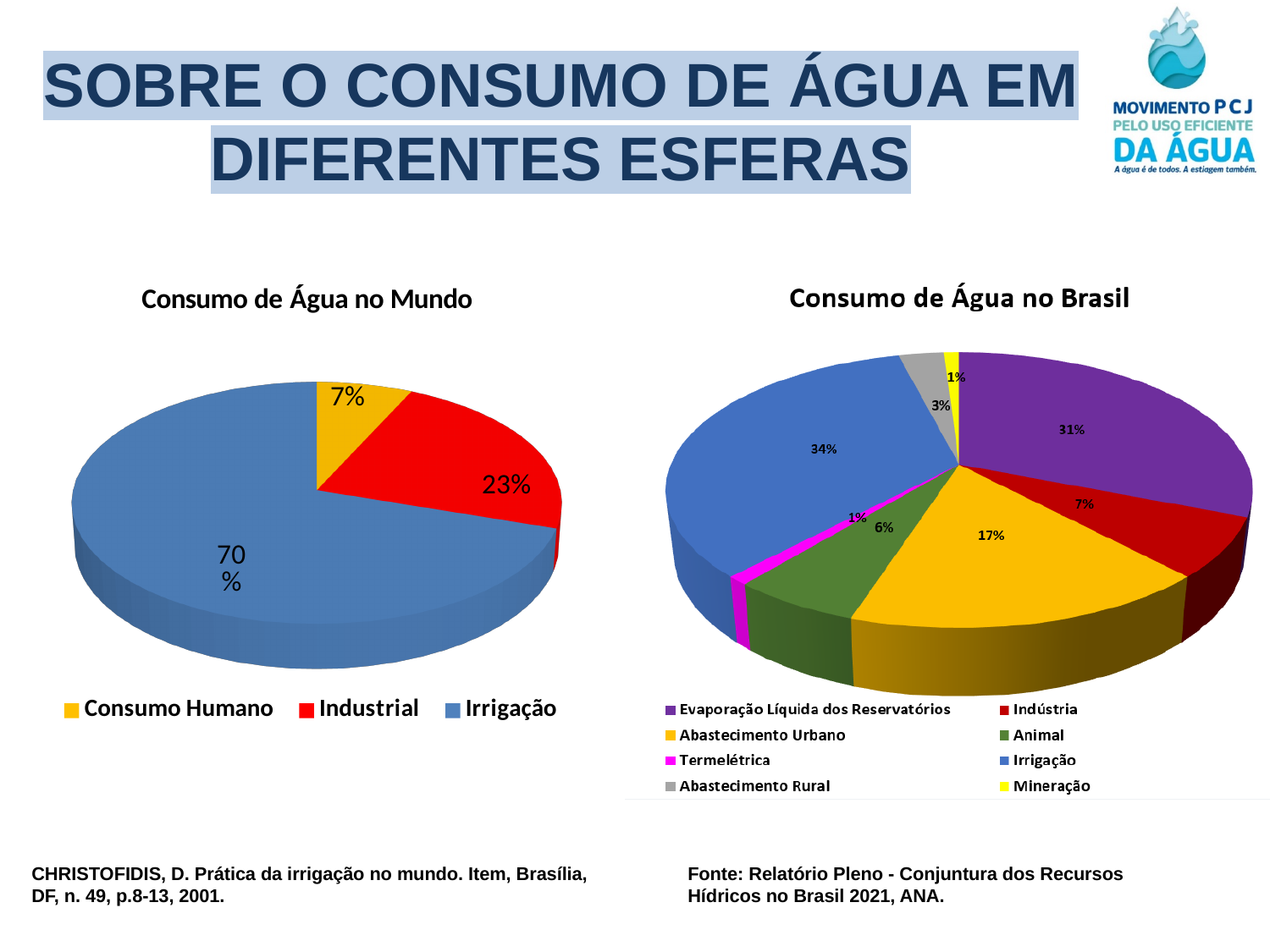
In the 'Consumo de Água no Mundo' chart, what share does Irrigação have? 70% In the 'Consumo de Água no Mundo' chart, what is the difference between the Industrial and Consumo Humano shares? 16% In the 'Consumo de Água no Brasil' chart, what share does Abastecimento Urbano have? 17% In the 'Consumo de Água no Mundo' chart, what share does Industrial have? 23% In the 'Consumo de Água no Brasil' chart, what is the difference between the Irrigação and Evaporação Líquida dos Reservatórios shares? 3% In the 'Consumo de Água no Brasil' chart, how many categories does the legend list? 8 In the 'Consumo de Água no Brasil' chart, what share does Irrigação have? 34% What kind of chart is 'Consumo de Água no Brasil'? Pie chart In the 'Consumo de Água no Brasil' chart, which category has the largest share? Irrigação In the 'Consumo de Água no Mundo' chart, how many categories does the legend list? 3 In the 'Consumo de Água no Mundo' chart, which category has the smallest share? Consumo Humano In the 'Consumo de Água no Brasil' chart, which is larger: Indústria or Animal? Indústria